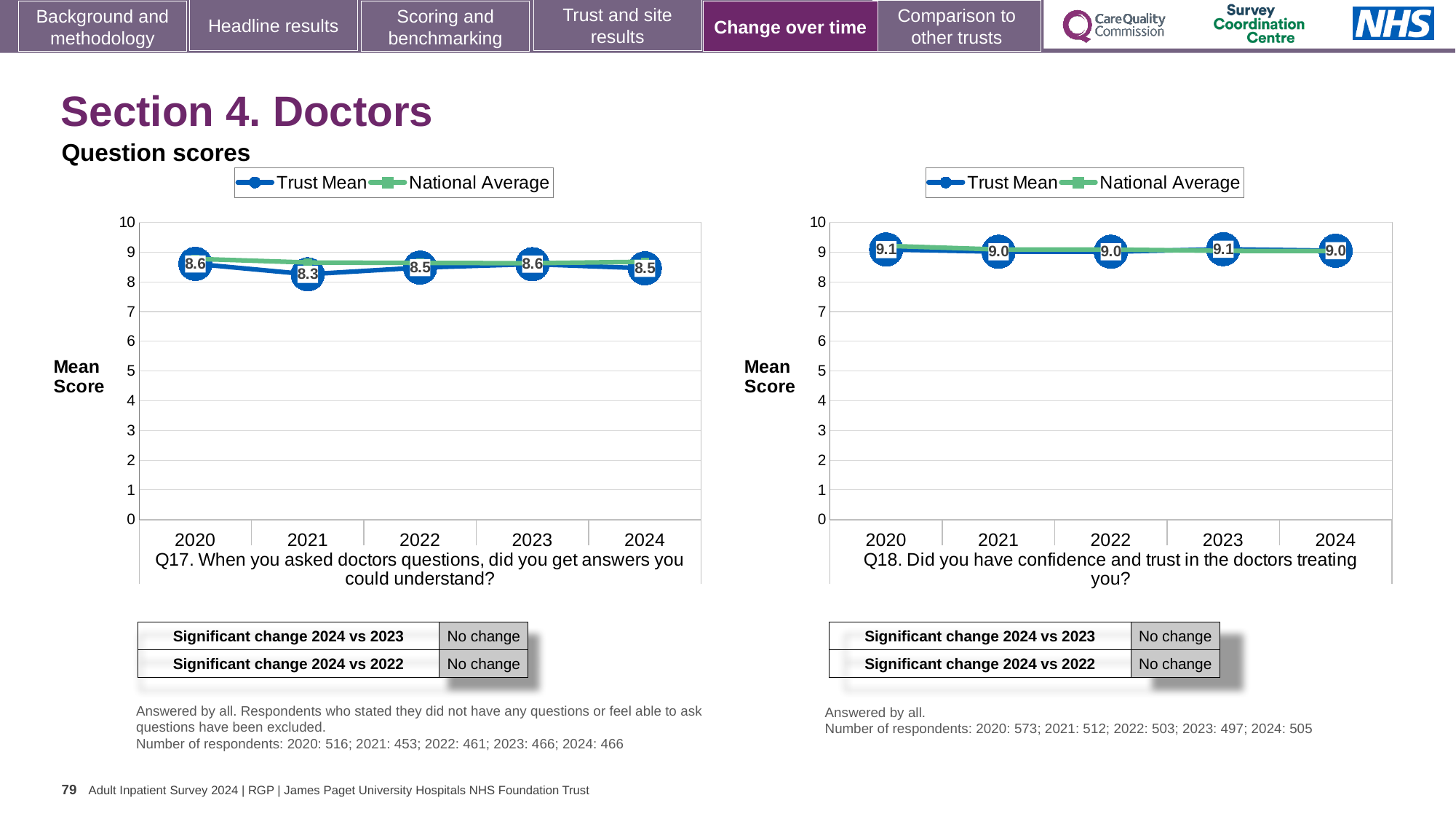
In the Q17 chart, what is the Trust Mean score for 2021? 8.3 In the Q17 chart, is the National Average value for 2021 greater or less than 8? greater What kind of chart is the Q18 chart? Line chart In the Q17 chart, which series is shown in green? National Average In the Q18 chart, what is the Trust Mean score for 2022? 9.0 In the Q17 chart, what is the Trust Mean score for 2024? 8.5 How many series does the legend of the Q17 chart list? 2 In the Q17 chart, what is the difference between the Trust Mean scores for 2023 and 2021? 0.3 In the Q17 chart, which year has the lowest Trust Mean score? 2021 In the Q18 chart, which is larger, the Trust Mean score for 2023 or for 2024? 2023 In the Q18 chart, what is the Trust Mean score for 2020? 9.1 How many years are plotted on the x axis of the Q18 chart? 5